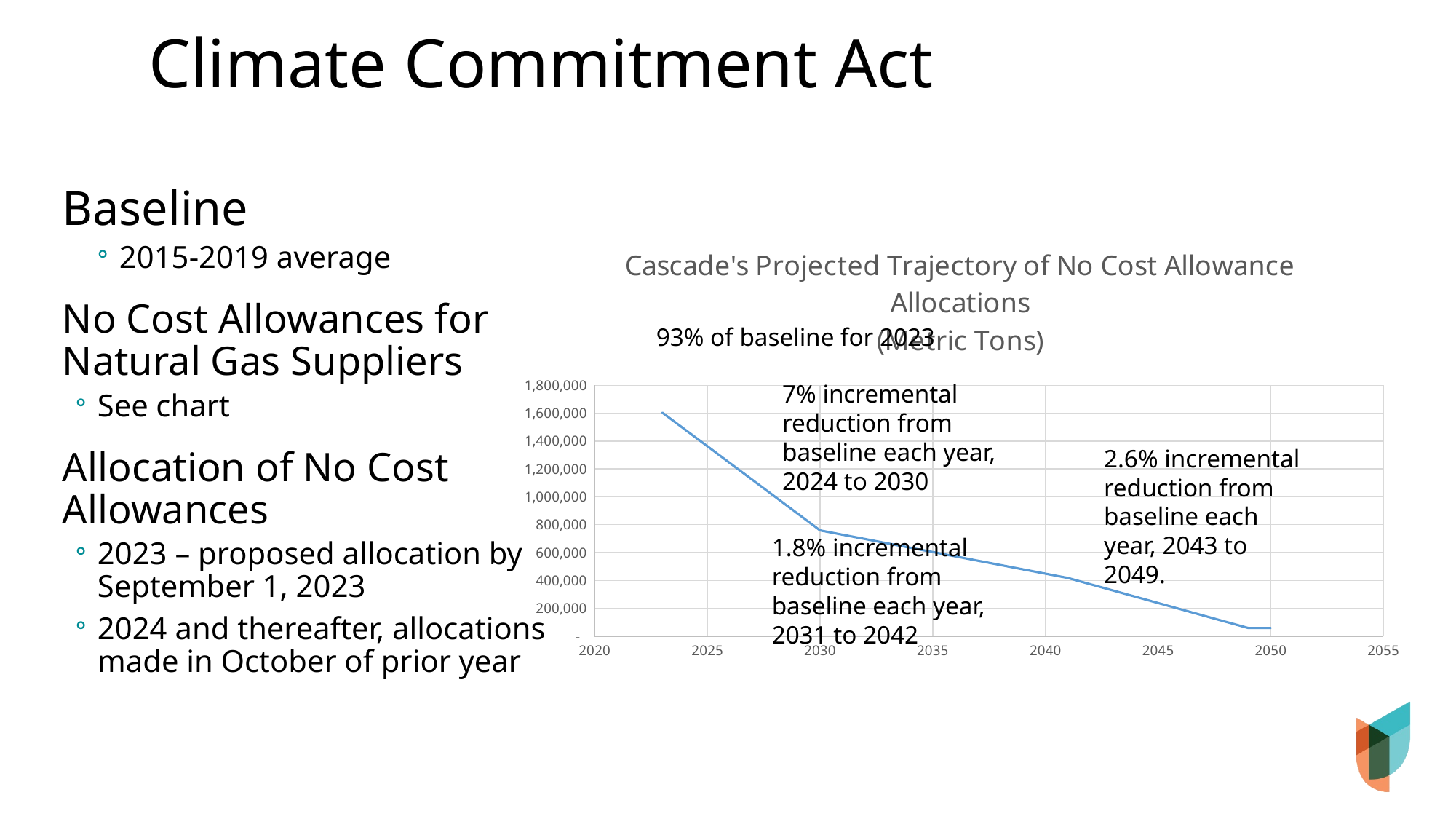
Is the value at the end of the line (around 2049) greater or less than 200,000? less Is the value at the start of the line (2023) greater or less than 1,400,000? greater What kind of chart is shown on the slide? line chart Is the value for 2030 greater or less than 1,000,000? less According to the chart annotation, what percentage of baseline is allocated for 2023? 93% Which year has the larger value, 2023 or 2030? 2023 Which year has the larger value, 2035 or 2045? 2035 What is the highest value shown on the y axis? 1,800,000 What is the title of the chart? Cascade's Projected Trajectory of No Cost Allowance Allocations (Metric Tons) Do the plotted values rise or fall as the years increase along the x axis? fall